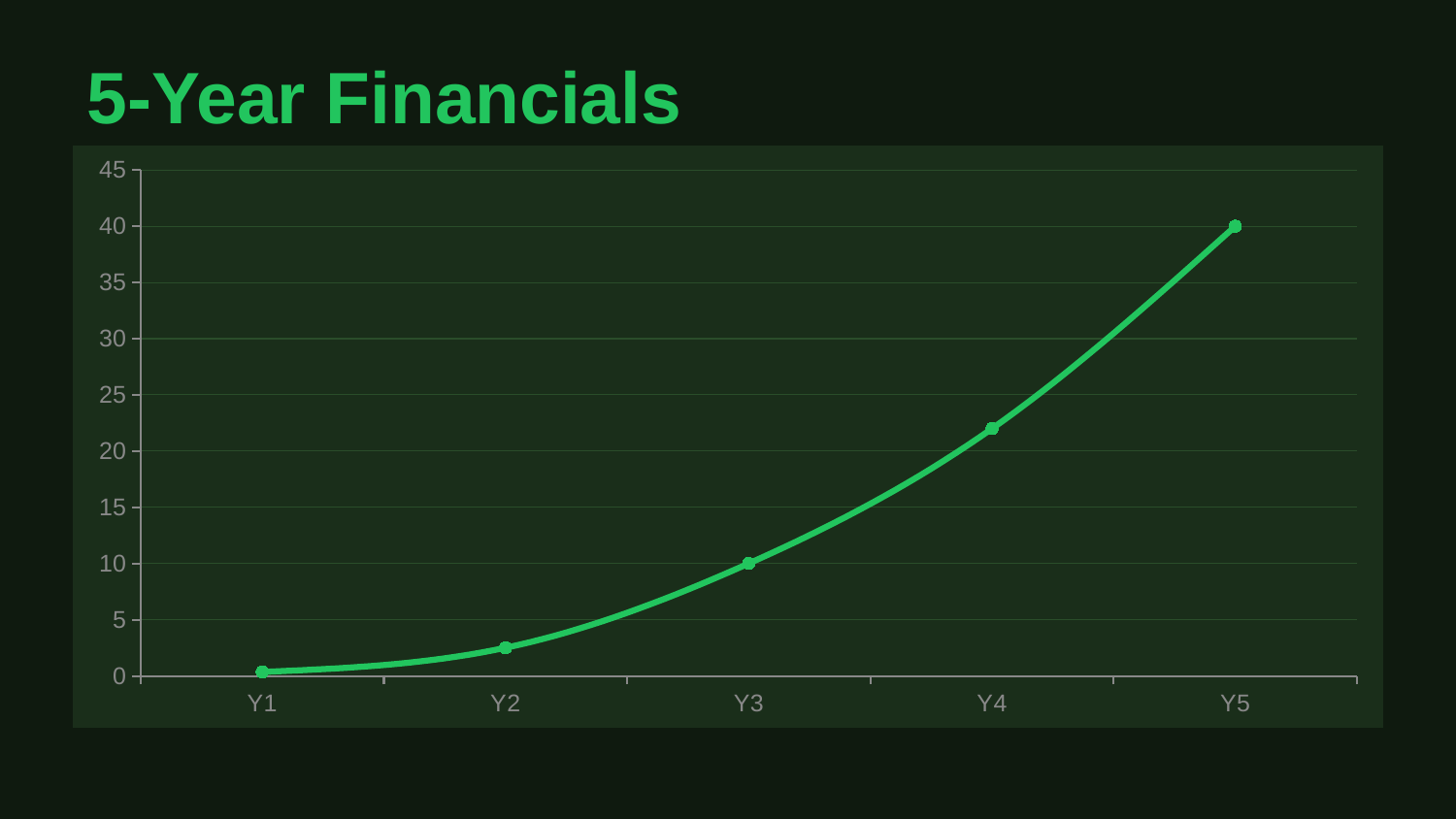
What is the title of the chart on the slide? 5-Year Financials Do the values rise or fall from Y1 to Y5? rise Which year has the highest value? Y5 Is the value for Y4 greater or less than 20? greater Which year has the lowest value? Y1 What is the highest value shown on the vertical axis? 45 What kind of chart is shown on the slide? line chart How many points are plotted on the line? 5 Is the value for Y2 greater or less than 5? less What is the value for Y5? 40 Which is larger, the value for Y4 or the value for Y2? Y4 What is the value for Y3? 10